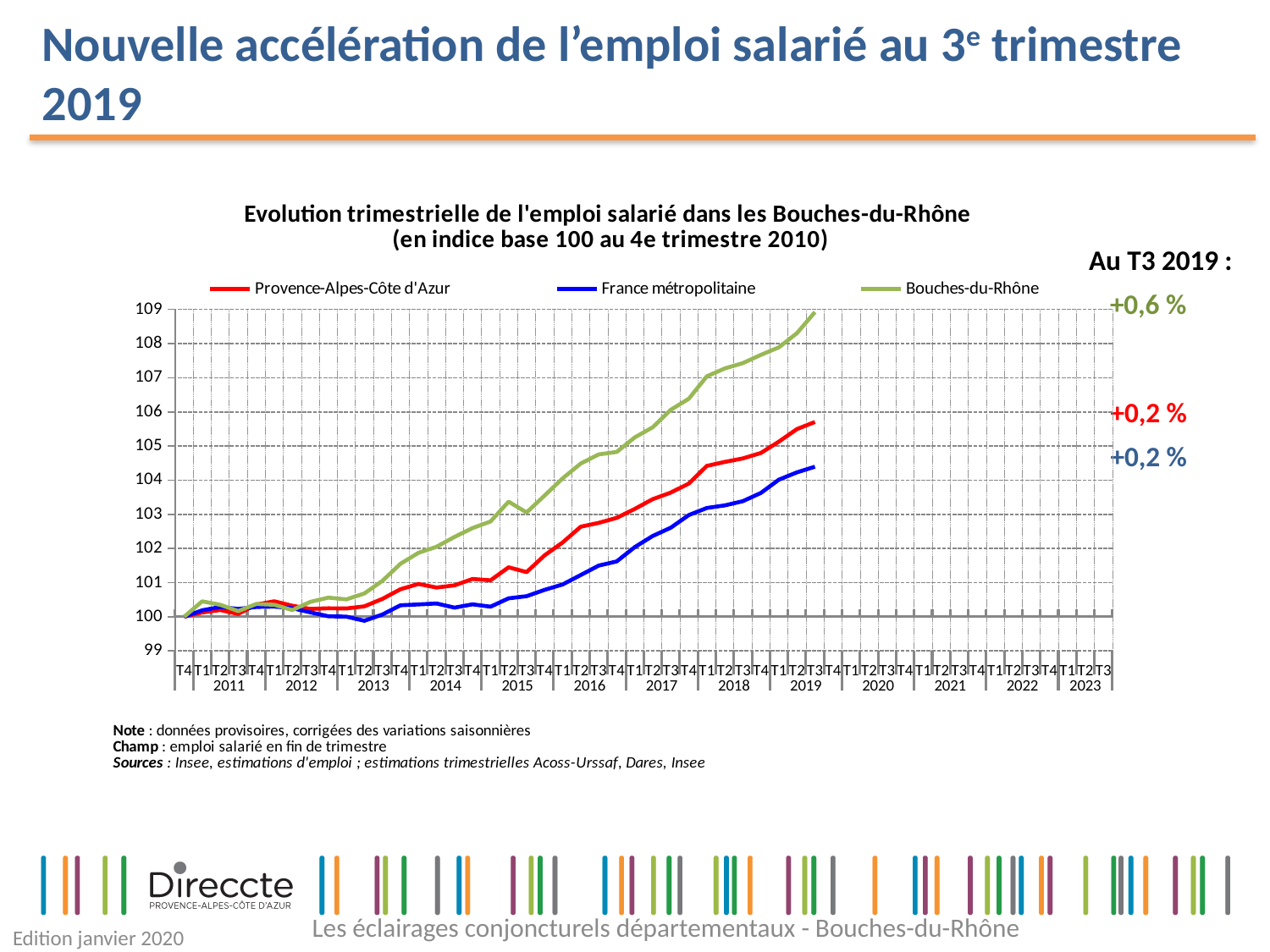
Is the value for Bouches-du-Rhône at T3 2019 greater or less than 108? greater Which series has the lowest value at T3 2019? France métropolitaine Is the value for France métropolitaine at T3 2019 greater or less than 105? less What is the title of the chart? Evolution trimestrielle de l'emploi salarié dans les Bouches-du-Rhône (en indice base 100 au 4e trimestre 2010) Which series is drawn in green in the chart? Bouches-du-Rhône Which series has the highest value at T3 2019? Bouches-du-Rhône According to the annotation on the slide, what is the quarterly change for Bouches-du-Rhône at T3 2019? +0,6 % What kind of chart is shown on the slide? line chart Does the Bouches-du-Rhône series rise or fall between 2013 and 2019? rise How many series does the legend of the chart list? 3 Is the value for Provence-Alpes-Côte d'Azur at T3 2019 greater or less than 105? greater At T3 2019, which is larger: the value for Provence-Alpes-Côte d'Azur or the value for France métropolitaine? Provence-Alpes-Côte d'Azur